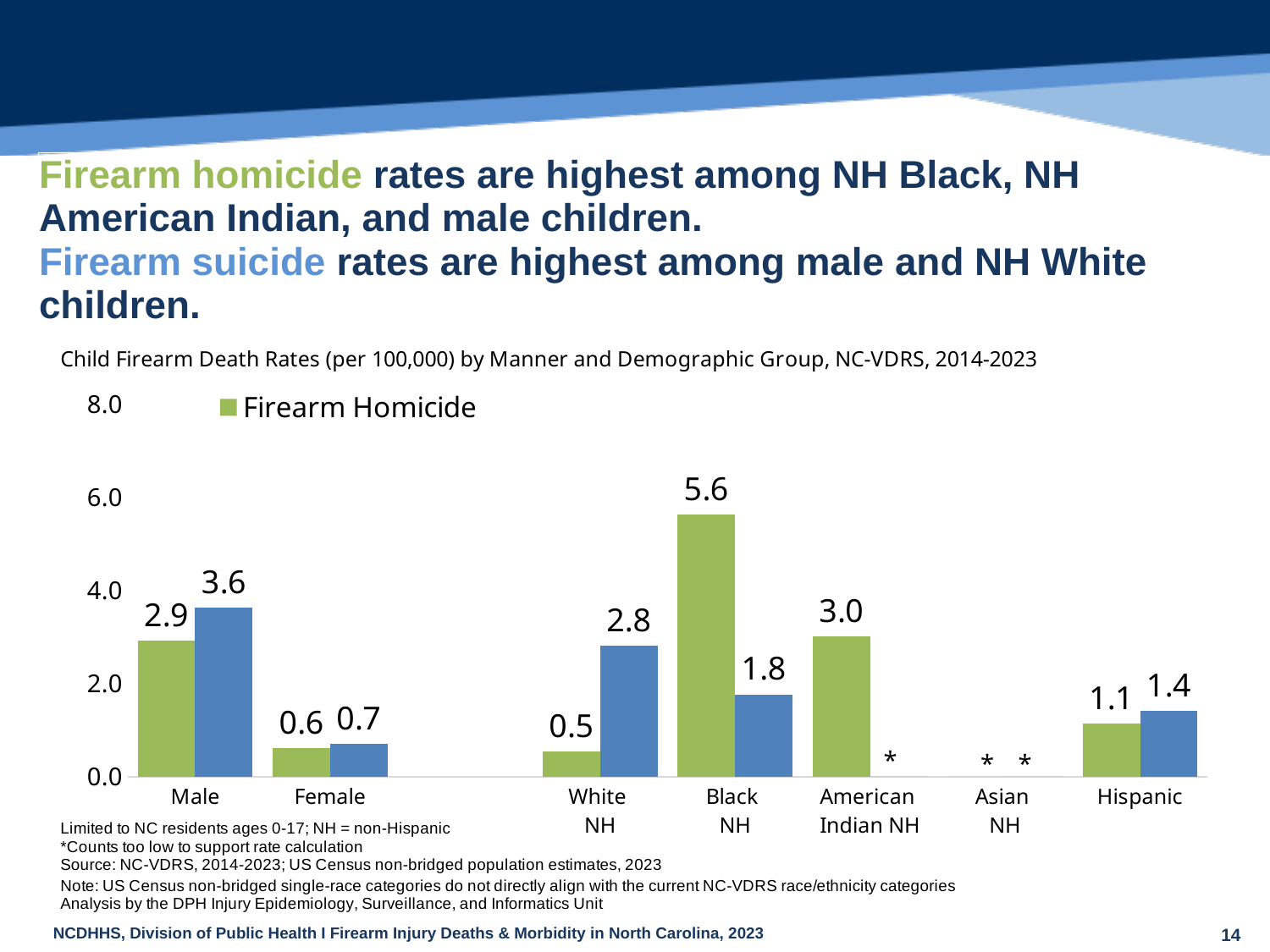
Among groups with a printed value, which has the lowest Firearm Homicide rate? White NH Which demographic group has the highest Firearm Homicide rate? Black NH What type of chart is shown on the slide? Bar chart Is the Firearm Homicide rate for Black NH children greater or less than 4.0? greater What is the Firearm Homicide rate for Black NH children? 5.6 What is the value of the blue (firearm suicide) bar for Hispanic children? 1.4 What is the Firearm Homicide rate for Male children? 2.9 What is the difference between the Firearm Homicide rate and the blue (firearm suicide) rate for Black NH children? 3.8 What is the difference between the Firearm Homicide rates for Male and Female children? 2.3 For Male children, which is larger: the Firearm Homicide rate or the blue (firearm suicide) rate? The blue (firearm suicide) rate, 3.6 What is the value of the blue (firearm suicide) bar for White NH children? 2.8 How many demographic groups are shown along the x axis? 7